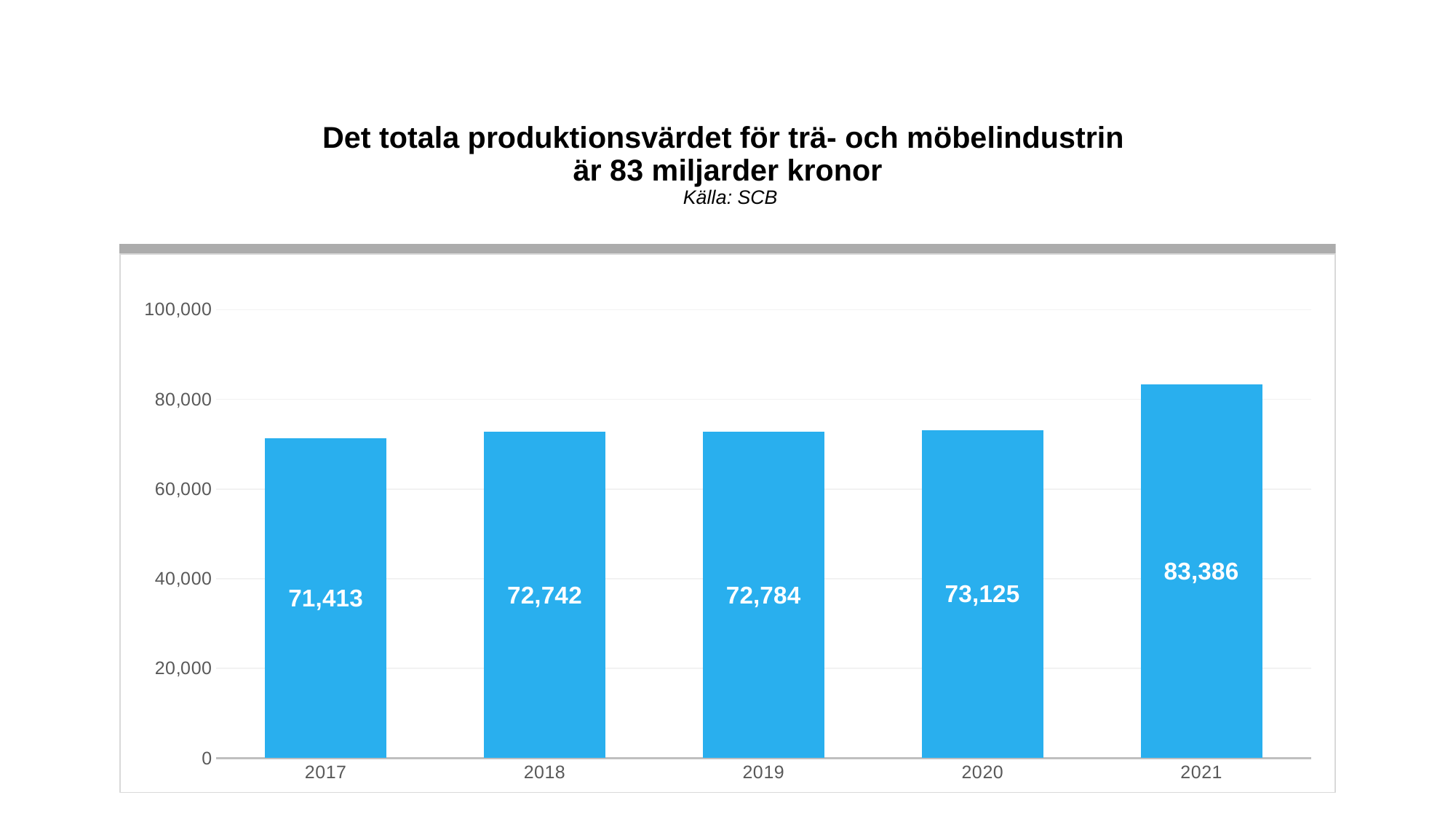
What is the value for 2019? 72,784 How many years are shown on the x axis? 5 Is the value for 2021 greater or less than 80,000? greater Which is larger, the value for 2020 or the value for 2017? 2020 What is the difference between the values for 2021 and 2020? 10,261 Which year has the highest value? 2021 What is the value for 2017? 71,413 What is the value for 2021? 83,386 What kind of chart is shown? bar chart What is the difference between the values for 2018 and 2017? 1,329 Which year has the lowest value? 2017 Do the values rise or fall from 2017 to 2021? rise